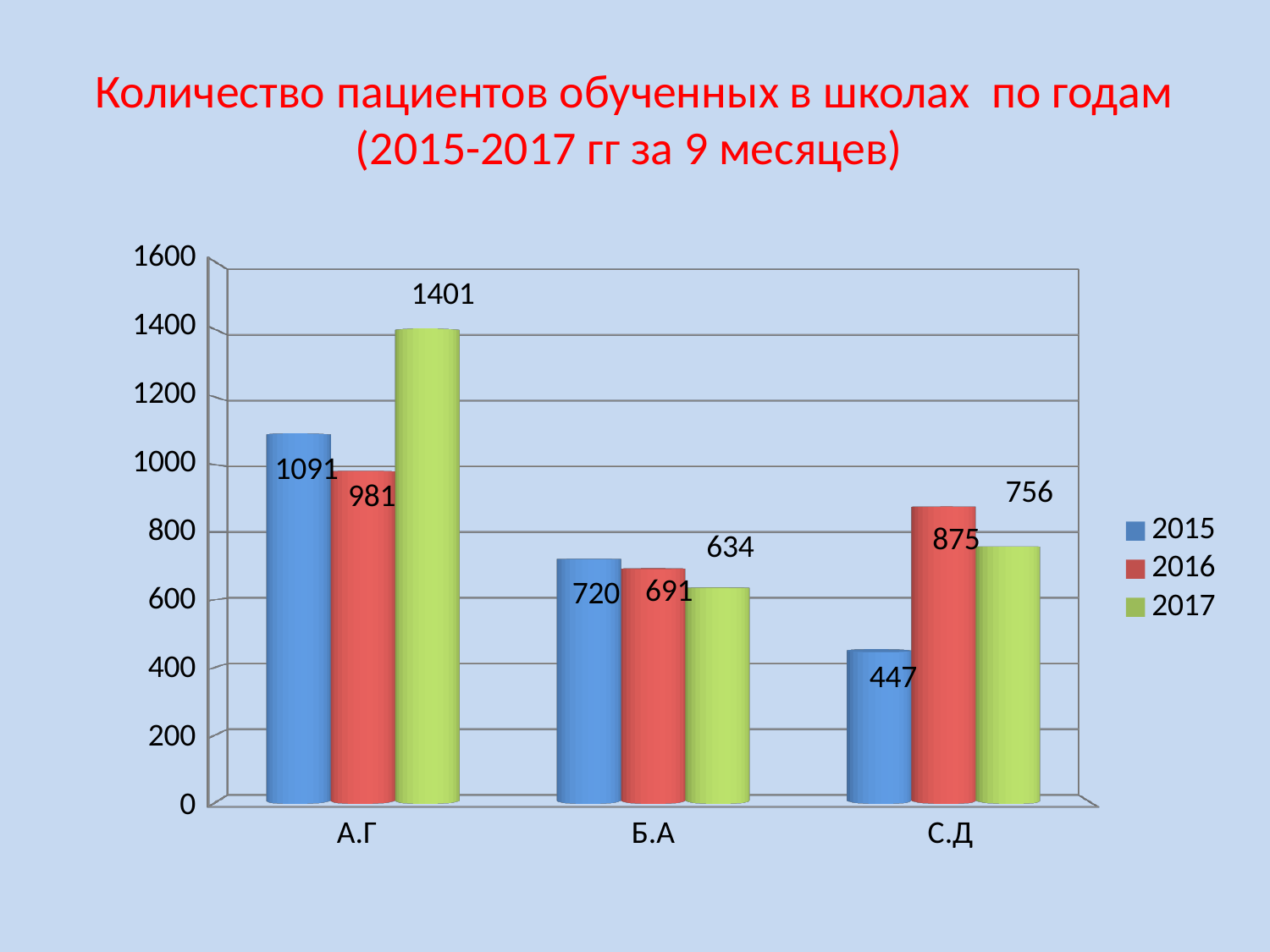
What is the value for А.Г in 2017? 1401 What is the value for Б.А in 2016? 691 Is the value for Б.А in 2015 greater or less than 600? greater What kind of chart is shown on the slide? bar chart What is the difference between the 2017 and 2015 values for А.Г? 310 Which is larger for С.Д: the 2016 value or the 2017 value? 2016 Which category has the highest value in the 2017 series? А.Г What is the value for С.Д in 2015? 447 How many categories are shown on the x axis? 3 What colour represents the 2016 series in the legend? red Which category has the lowest value in the 2015 series? С.Д How many series does the legend list? 3